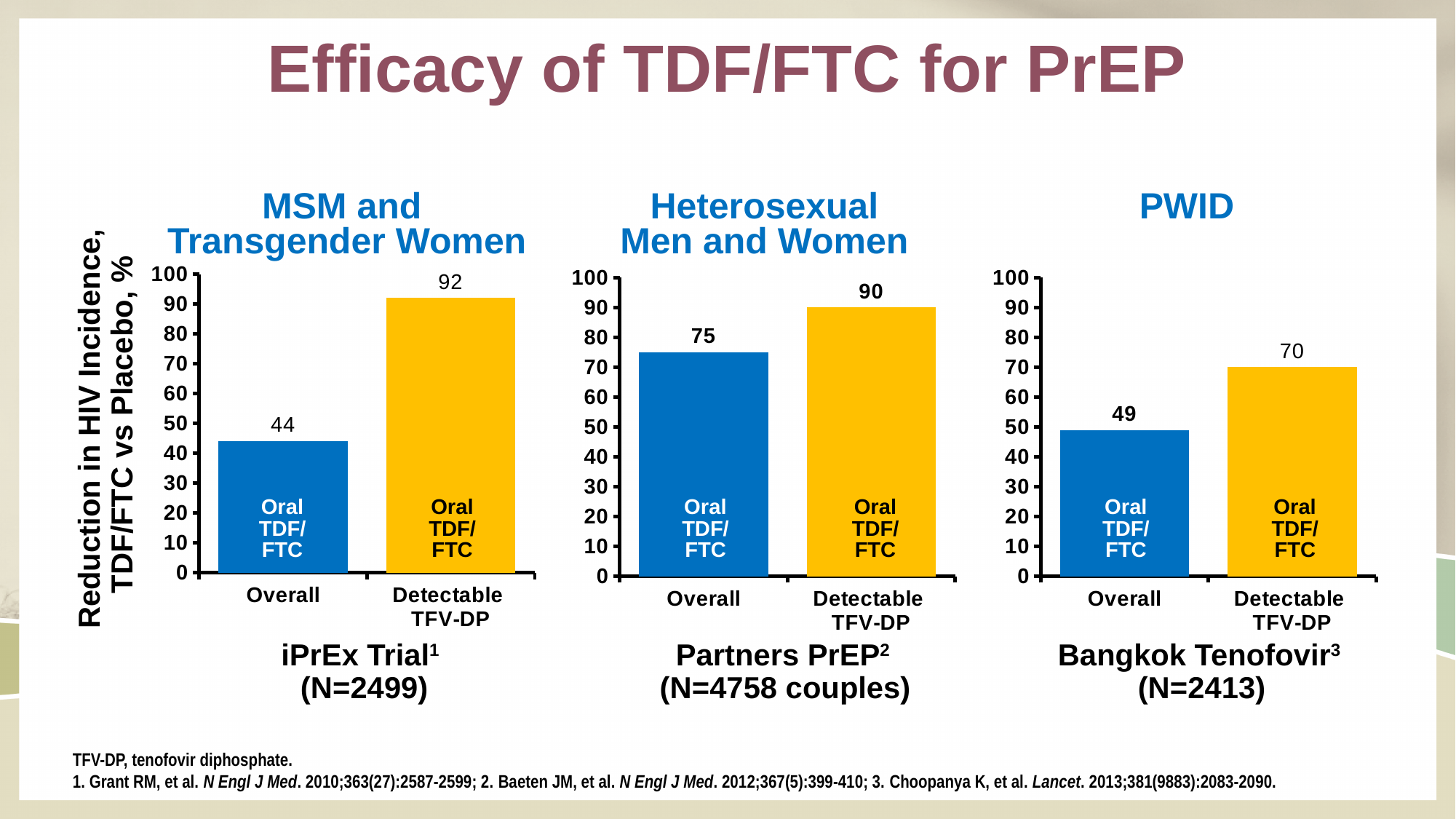
In the PWID chart (Bangkok Tenofovir), what is the value for Overall? 49 In the Heterosexual Men and Women chart (Partners PrEP), what is the value for Detectable TFV-DP? 90 What type of chart is the MSM and Transgender Women chart (iPrEx Trial)? Bar chart In the MSM and Transgender Women chart (iPrEx Trial), what is the difference between the Detectable TFV-DP and Overall values? 48 In the MSM and Transgender Women chart (iPrEx Trial), what is the value for Overall? 44 In the PWID chart (Bangkok Tenofovir), what is the value for Detectable TFV-DP? 70 In the Heterosexual Men and Women chart (Partners PrEP), which category has the higher value, Overall or Detectable TFV-DP? Detectable TFV-DP In the PWID chart (Bangkok Tenofovir), what is the difference between the Detectable TFV-DP and Overall values? 21 What is the y-axis label shared by the three charts? Reduction in HIV Incidence, TDF/FTC vs Placebo, % In the MSM and Transgender Women chart (iPrEx Trial), what is the value for Detectable TFV-DP? 92 In the Heterosexual Men and Women chart (Partners PrEP), what is the value for Overall? 75 How many bars are plotted in the PWID chart (Bangkok Tenofovir)? 2